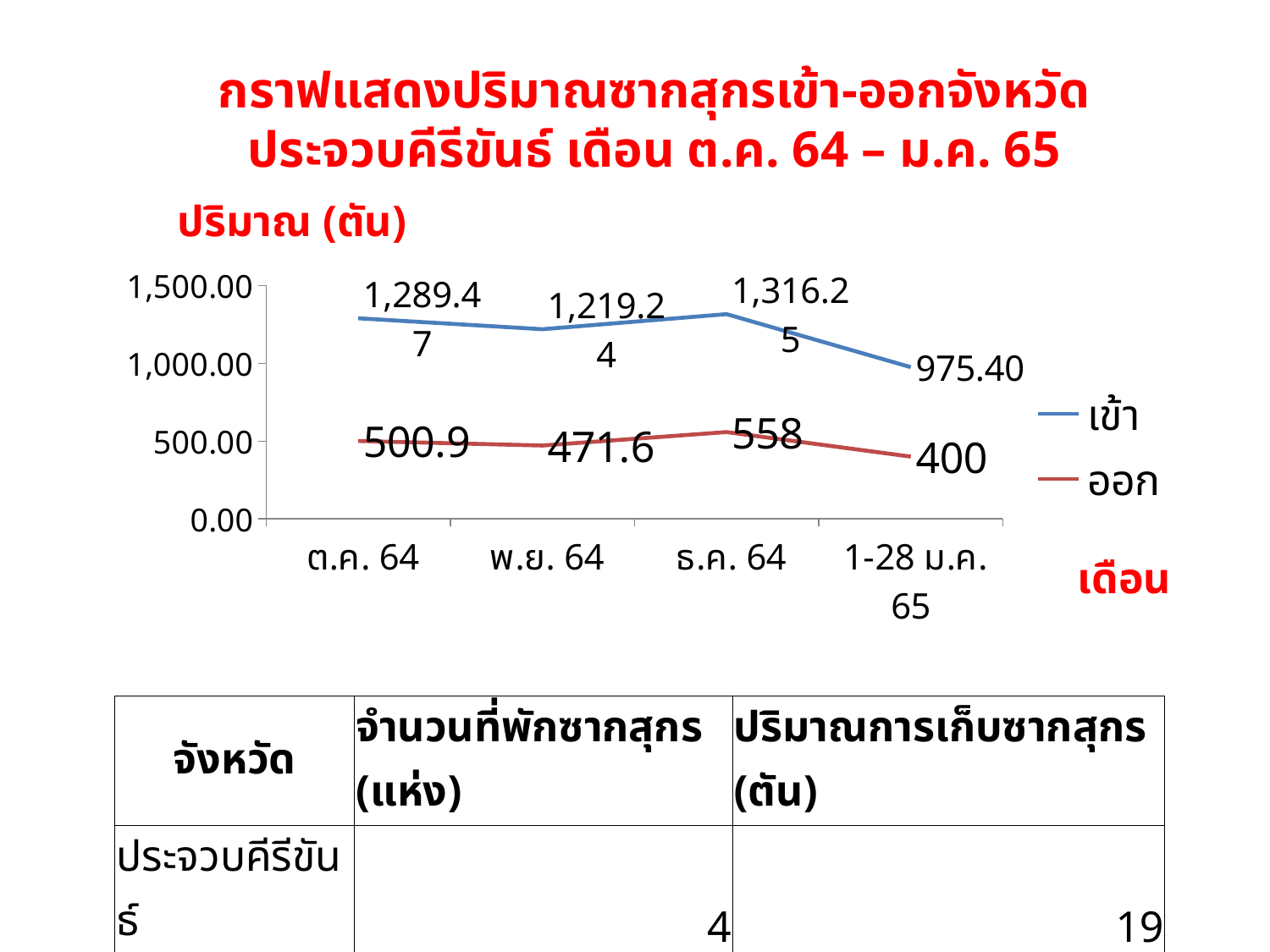
Does the เข้า series rise or fall from ธ.ค. 64 to 1-28 ม.ค. 65? fall How many series does the chart legend list? 2 What is the difference between ออก in ธ.ค. 64 and ออก in 1-28 ม.ค. 65? 158 What kind of chart is shown on the slide? line chart What is the label of the y axis? ปริมาณ (ตัน) In which month is the เข้า series highest? ธ.ค. 64 How many months (categories) are plotted along the x axis? 4 Which is larger: เข้า in พ.ย. 64 or เข้า in ธ.ค. 64? ธ.ค. 64 What is the value of เข้า for 1-28 ม.ค. 65? 975.40 What is the value of ออก for พ.ย. 64? 471.6 What is the value of เข้า for ต.ค. 64? 1,289.47 In which month is the ออก series lowest? 1-28 ม.ค. 65